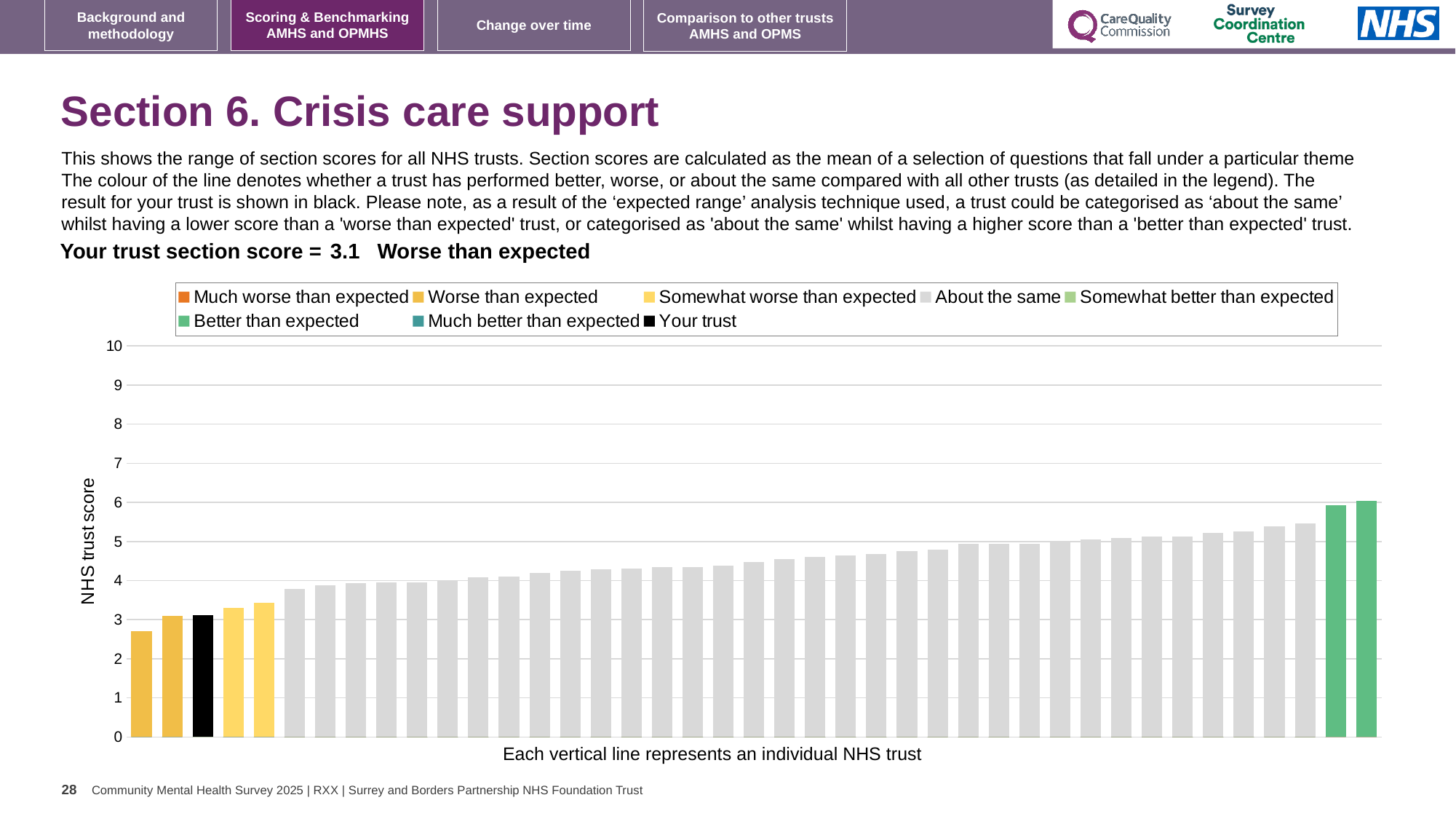
What is the label on the vertical axis? NHS trust score Is the highest bar in the chart greater or less than 5? greater How many bars are coloured as 'Better than expected'? 2 Which legend category do the highest bars in the chart belong to? Better than expected What kind of chart is shown on the slide? bar chart What does the text below the x axis say each vertical line represents? an individual NHS trust Is the value for your trust (black bar) greater or less than 4? less Which category is your trust placed in for this section? Worse than expected Is the lowest bar in the chart greater or less than 3? less What is the section score for your trust? 3.1 Do the bar values rise or fall from left to right along the x axis? rise How many entries does the legend list? 8